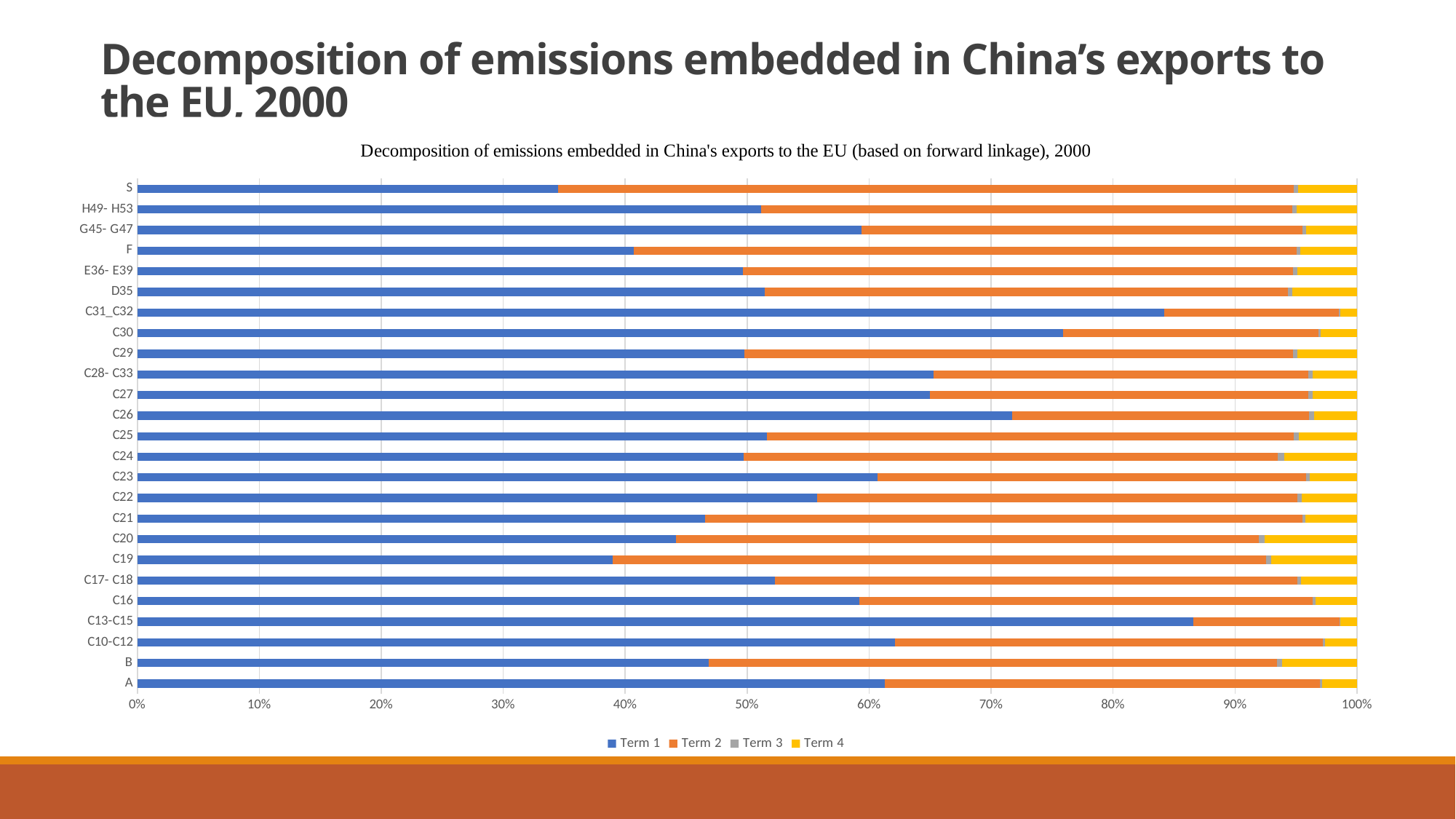
How many series does the legend list? 4 What is the total each stacked bar reaches on the horizontal axis? 100% How many categories are plotted on the vertical axis? 25 What is the title printed above the chart? Decomposition of emissions embedded in China's exports to the EU (based on forward linkage), 2000 Which category has the smallest Term 1 share? S Is the Term 1 value for S greater or less than 40%? less What kind of chart is shown on the slide? Bar chart Which has the larger Term 1 share, A or B? A Is the Term 1 value for C30 greater or less than 70%? greater Which has the larger Term 1 share, C30 or C29? C30 Is the Term 1 value for C13-C15 greater or less than 80%? greater